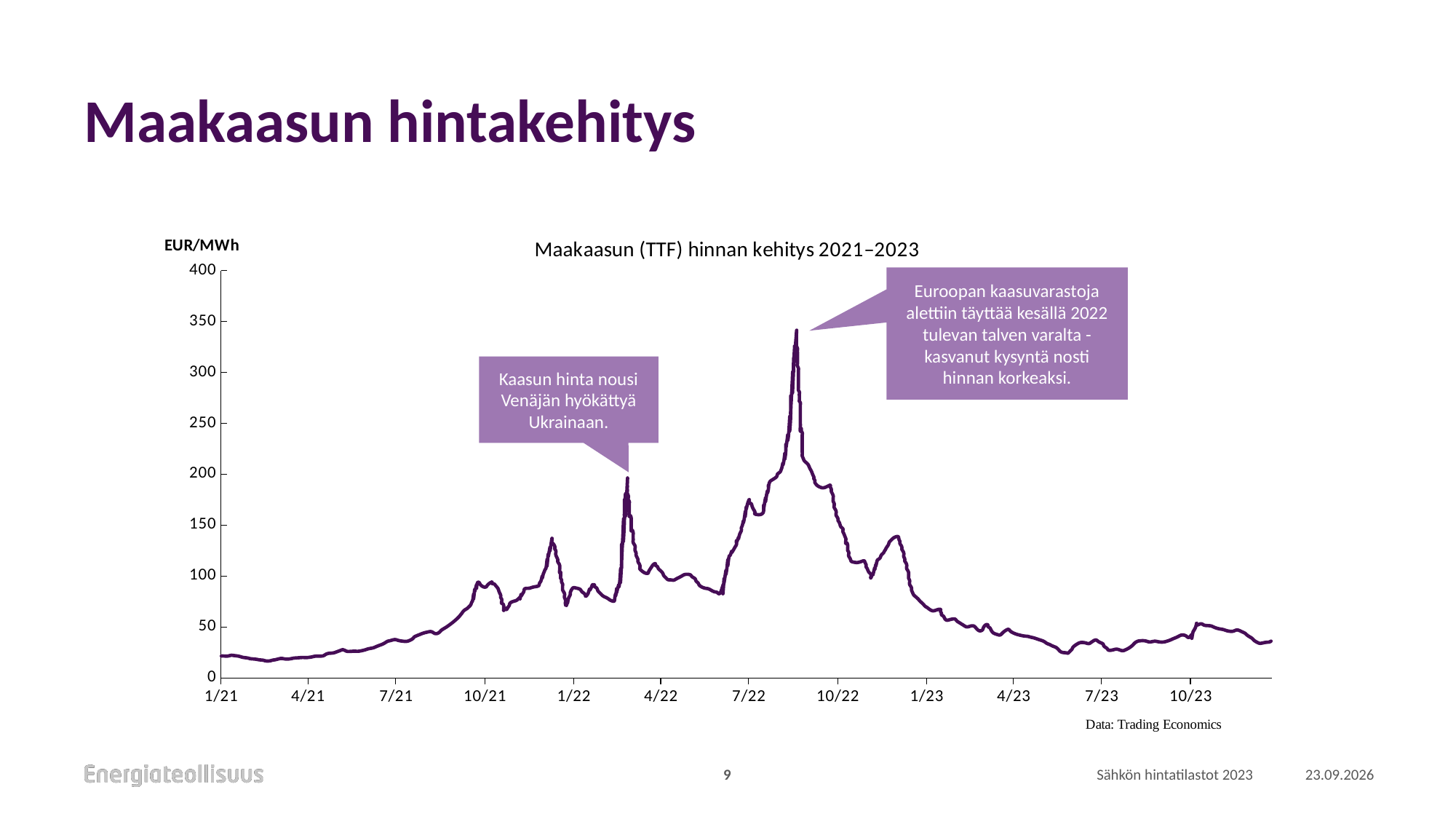
What kind of chart is shown on the slide? line chart Does the line generally rise or fall from 10/22 to 4/23? fall Is the value at 1/21 greater or less than 50? less How many lines (series) are plotted in the chart? 1 What unit is shown on the vertical axis of the chart? EUR/MWh Does the line generally rise or fall from 1/21 to 10/21? rise What is the title of the chart? Maakaasun (TTF) hinnan kehitys 2021–2023 Is the value at 1/23 greater or less than 100? less Between which two x-axis labels does the line reach its highest peak? between 7/22 and 10/22 Is the highest value of the line greater or less than 300? greater Which is higher: the peak between 1/22 and 4/22 or the peak between 7/22 and 10/22? the peak between 7/22 and 10/22